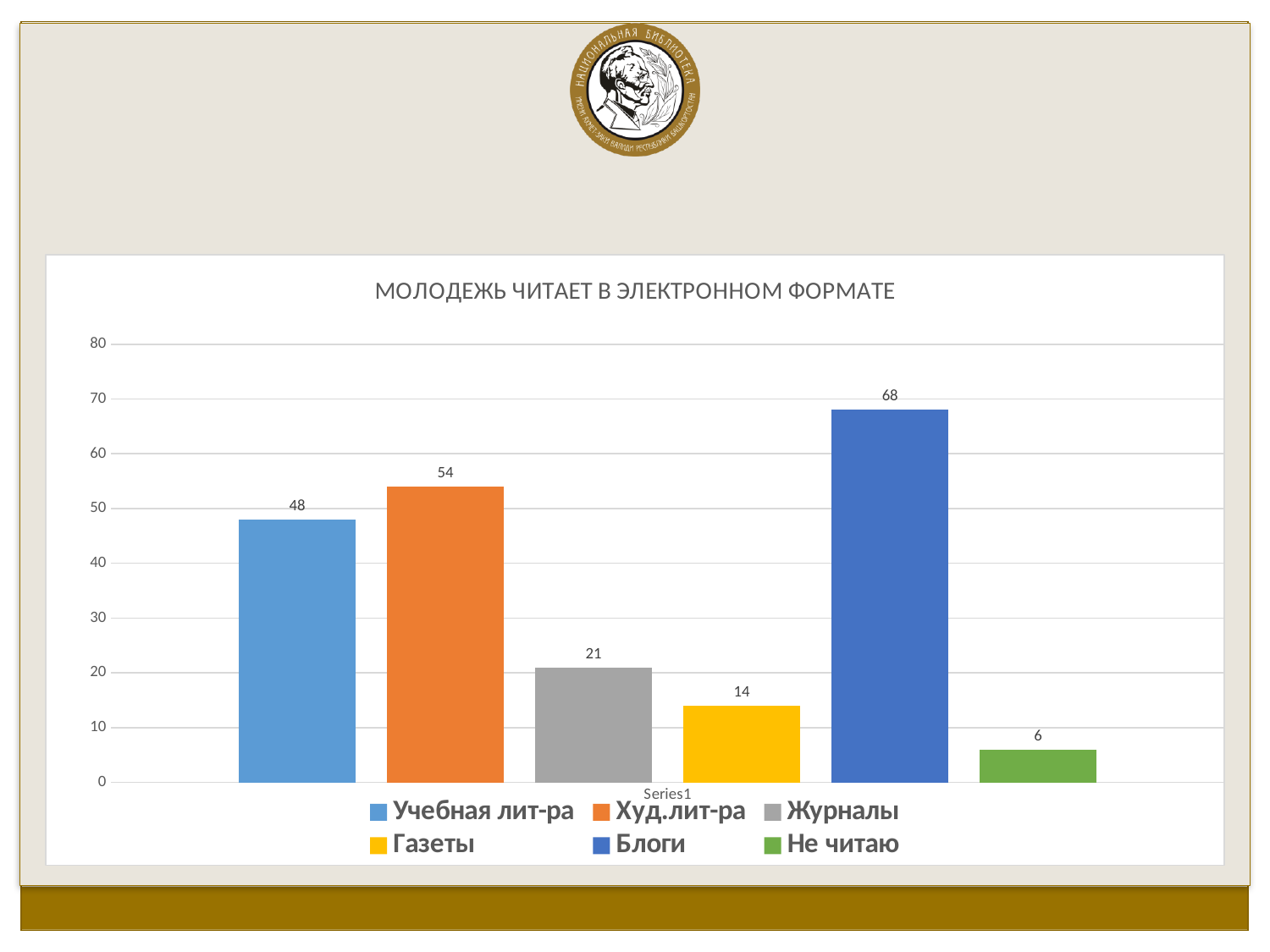
Which category has the highest value? Блоги How many bars are shown in the chart? 6 What is the value for Газеты? 14 What kind of chart is shown on the slide? Bar chart What is the difference between the values for Журналы and Не читаю? 15 Which is larger, the value for Худ.лит-ра or the value for Учебная лит-ра? Худ.лит-ра What is the value for Блоги? 68 What is the title of the chart? МОЛОДЕЖЬ ЧИТАЕТ В ЭЛЕКТРОННОМ ФОРМАТЕ What is the difference between the values for Блоги and Худ.лит-ра? 14 How many entries does the legend list? 6 What is the value for Учебная лит-ра? 48 Which category has the lowest value? Не читаю